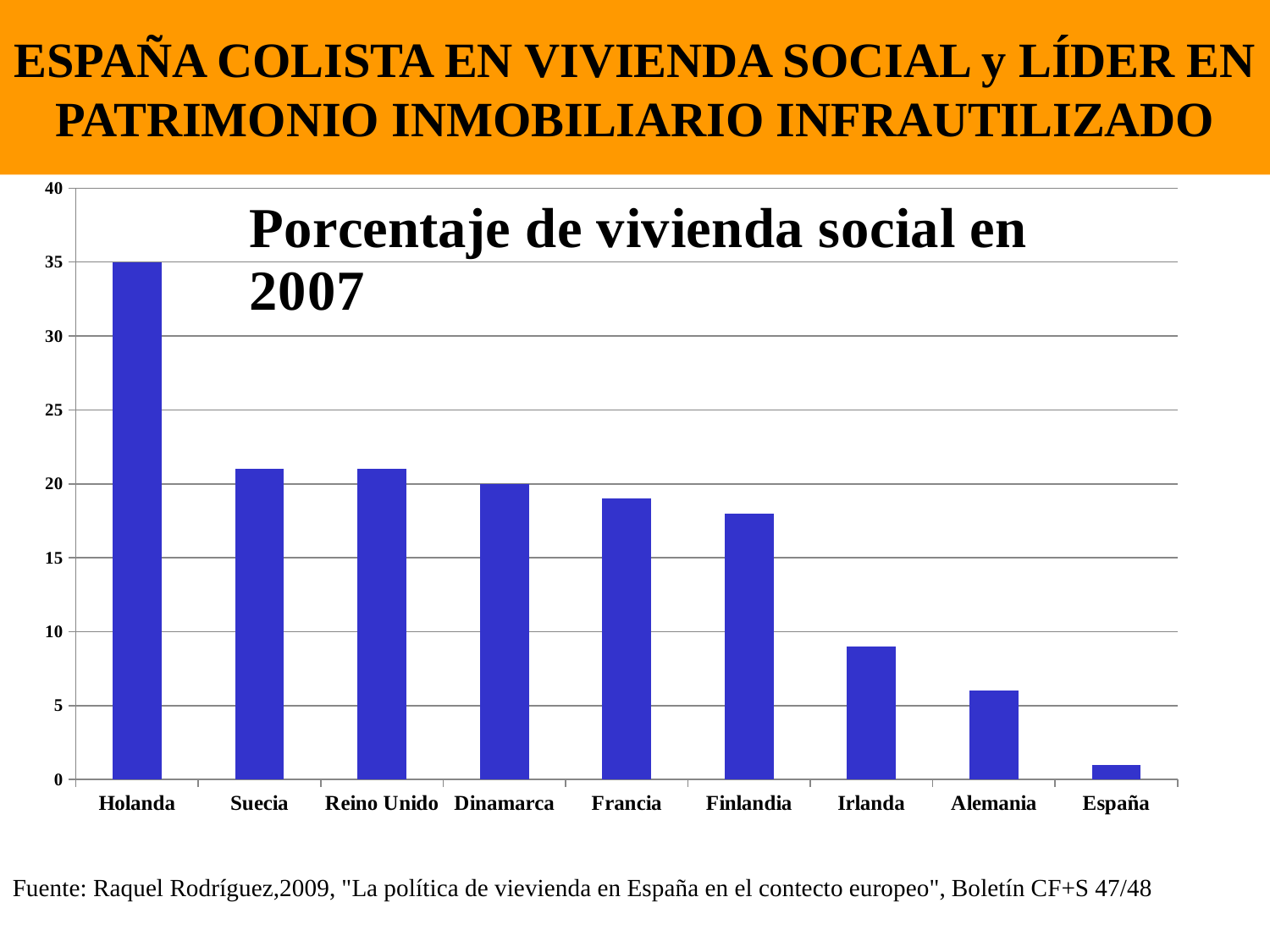
Which country has the lowest percentage of social housing in the chart? España What type of chart is shown on the slide? bar chart What is the value for Dinamarca in the chart? 20 Is the value for Alemania greater or less than 5? greater What is the title of the chart? Porcentaje de vivienda social en 2007 Do the values generally rise or fall from left to right along the x axis? fall Is the value for Francia greater or less than 15? greater Which country has the highest percentage of social housing in the chart? Holanda Which has a larger value, Finlandia or Irlanda? Finlandia What is the value for Holanda in the chart? 35 How many countries are shown on the x axis of the chart? 9 Is the value for Irlanda greater or less than 10? less